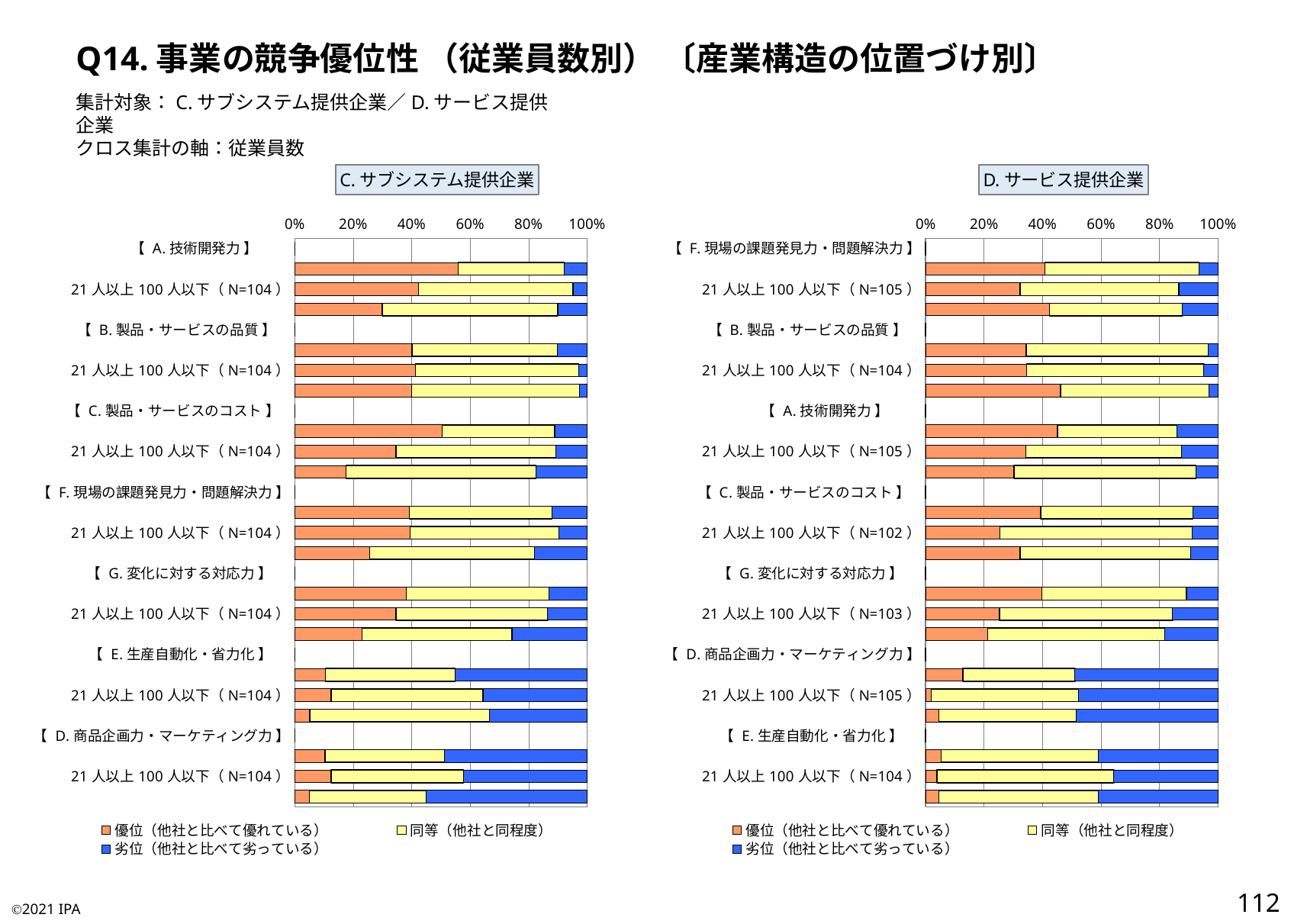
In the left chart (C. サブシステム提供企業), is the 優位 share for the 21人以上100人以下 row under B. 製品・サービスの品質 greater or less than 20%? greater In the left chart (C. サブシステム提供企業), how many 【】 item headings (A–G) are shown on the category axis? 7 How many series does the legend of the right chart (D. サービス提供企業) list? 3 In the right chart (D. サービス提供企業), is the 優位 share for the 21人以上100人以下 row under B. 製品・サービスの品質 greater or less than 20%? greater In the right chart (D. サービス提供企業), is the 優位 share for the 21人以上100人以下 row under D. 商品企画力・マーケティング力 greater or less than 20%? less Which legend entry is shown in blue on both charts? 劣位（他社と比べて劣っている） In the left chart (C. サブシステム提供企業), for the 21人以上100人以下 rows, which has the larger 優位 share: B. 製品・サービスの品質 or E. 生産自動化・省力化? B. 製品・サービスの品質 In the right chart (D. サービス提供企業), what is the N value shown for the 21人以上100人以下 row under C. 製品・サービスのコスト? N=102 In the right chart (D. サービス提供企業), for the 21人以上100人以下 rows, which has the larger 優位 share: F. 現場の課題発見力・問題解決力 or D. 商品企画力・マーケティング力? F. 現場の課題発見力・問題解決力 What kind of chart is the left chart titled C. サブシステム提供企業? stacked bar chart